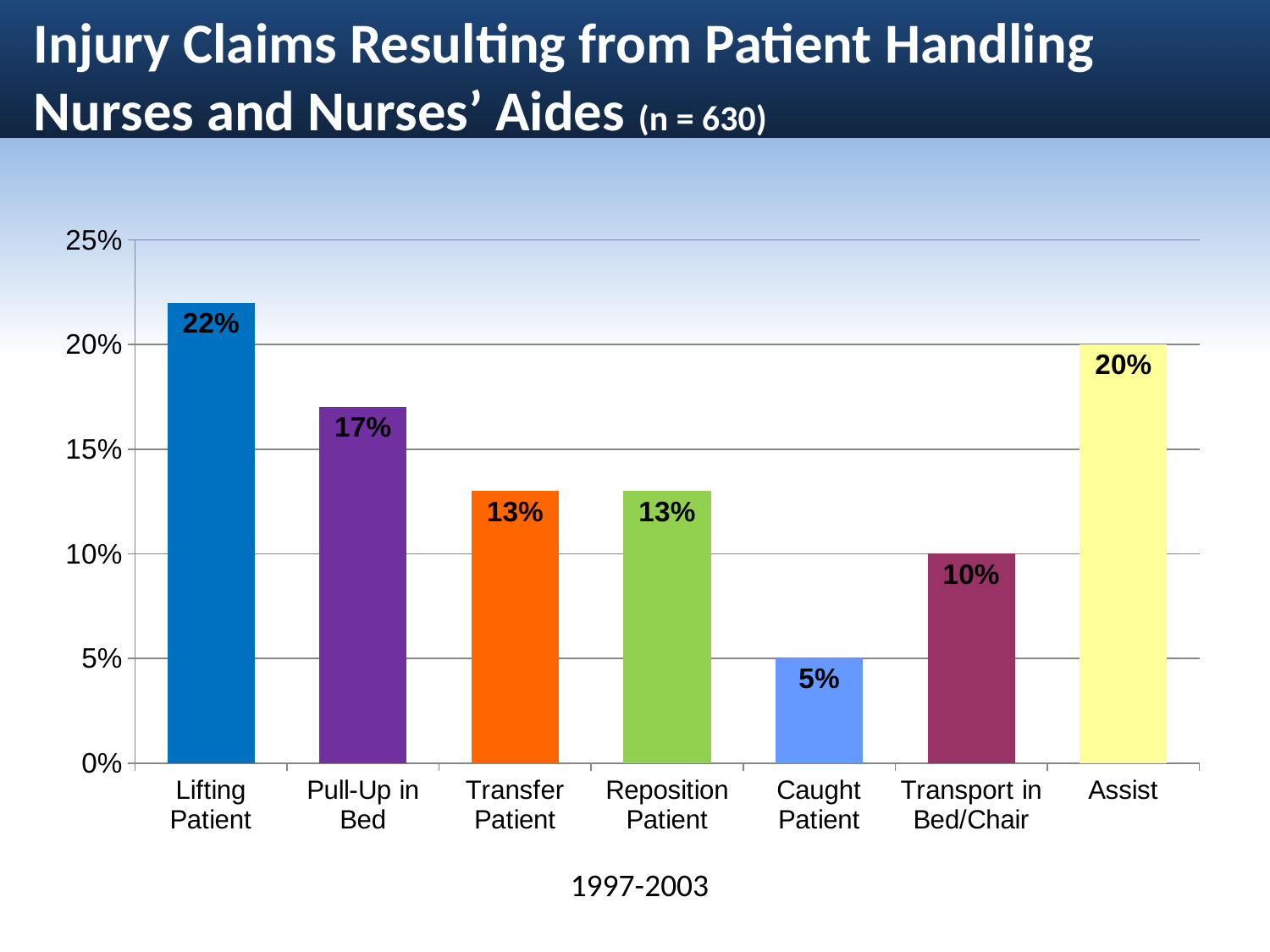
What kind of chart is shown on the slide? bar chart Which category has the lowest percentage of injury claims? Caught Patient What is the value shown for Assist? 20% What percentage of injury claims resulted from Lifting Patient? 22% What is the difference between the values for Assist and Caught Patient? 15% Which category has the highest percentage of injury claims? Lifting Patient What is the value shown for Transport in Bed/Chair? 10% Which is larger, the value for Pull-Up in Bed or the value for Assist? Assist What is the difference between the values for Lifting Patient and Pull-Up in Bed? 5% Is the value for Transfer Patient greater or less than 15%? less What time period is labelled below the x axis of the chart? 1997-2003 How many categories are shown on the x axis? 7